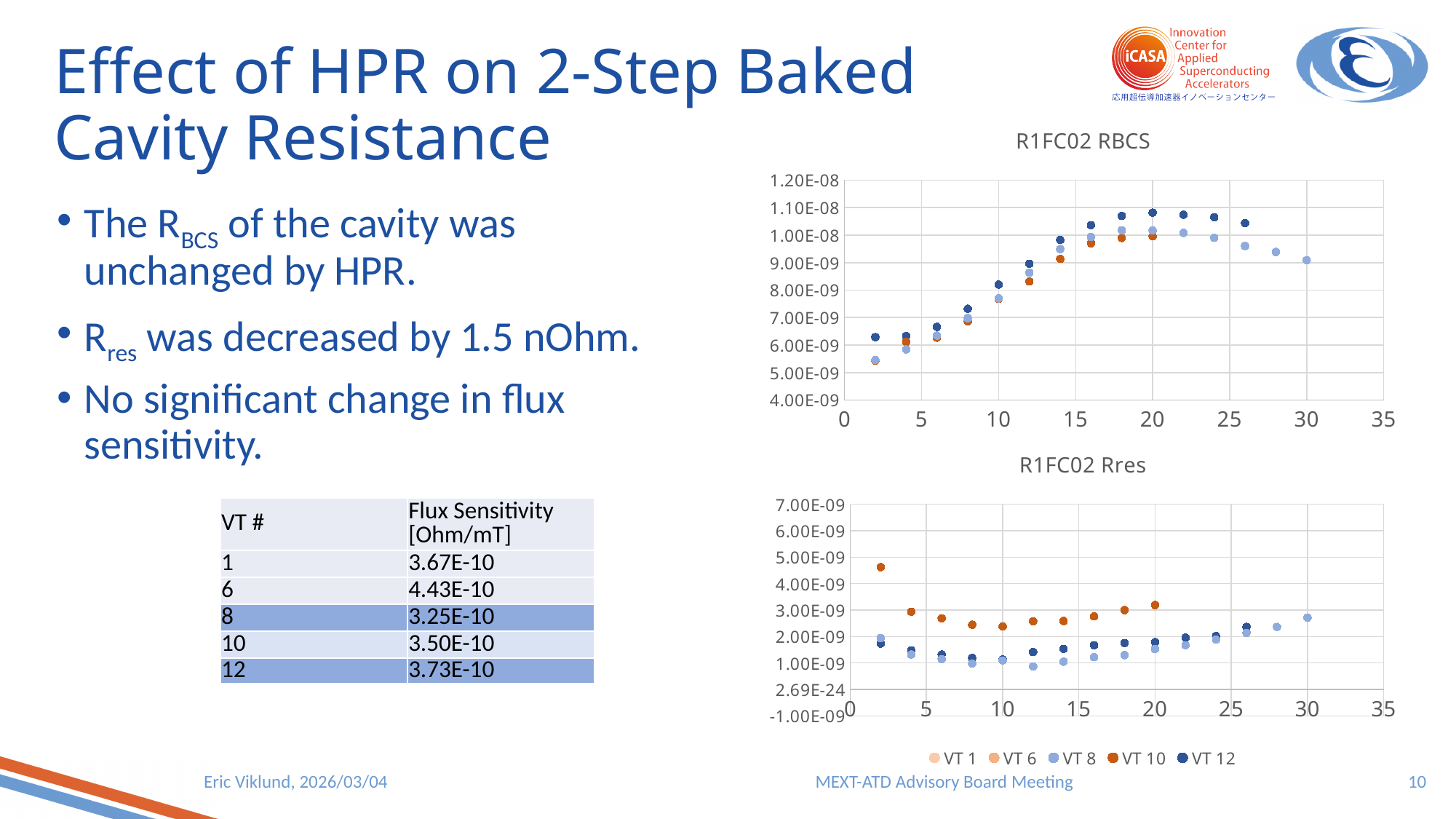
In the R1FC02 RBCS chart, is the VT 8 value at x = 30 greater or less than 1.00E-08? less In the R1FC02 Rres chart, is the VT 10 value at x = 2 greater or less than 4.00E-09? greater In the R1FC02 Rres chart, which series has the highest value at x = 2? VT 10 What is the title of the bottom chart? R1FC02 Rres In the R1FC02 Rres chart, is the VT 8 value at x = 30 greater or less than 2.00E-09? greater What is the title of the top chart? R1FC02 RBCS What kind of chart is the R1FC02 RBCS chart? scatter chart In the R1FC02 RBCS chart, at x = 20, which series has the larger value, VT 12 or VT 10? VT 12 How many series does the legend list for the charts? 5 In the R1FC02 RBCS chart, do the values rise or fall along the x axis between x = 2 and x = 20? rise In the R1FC02 Rres chart, at x = 2, which series has the larger value, VT 10 or VT 12? VT 10